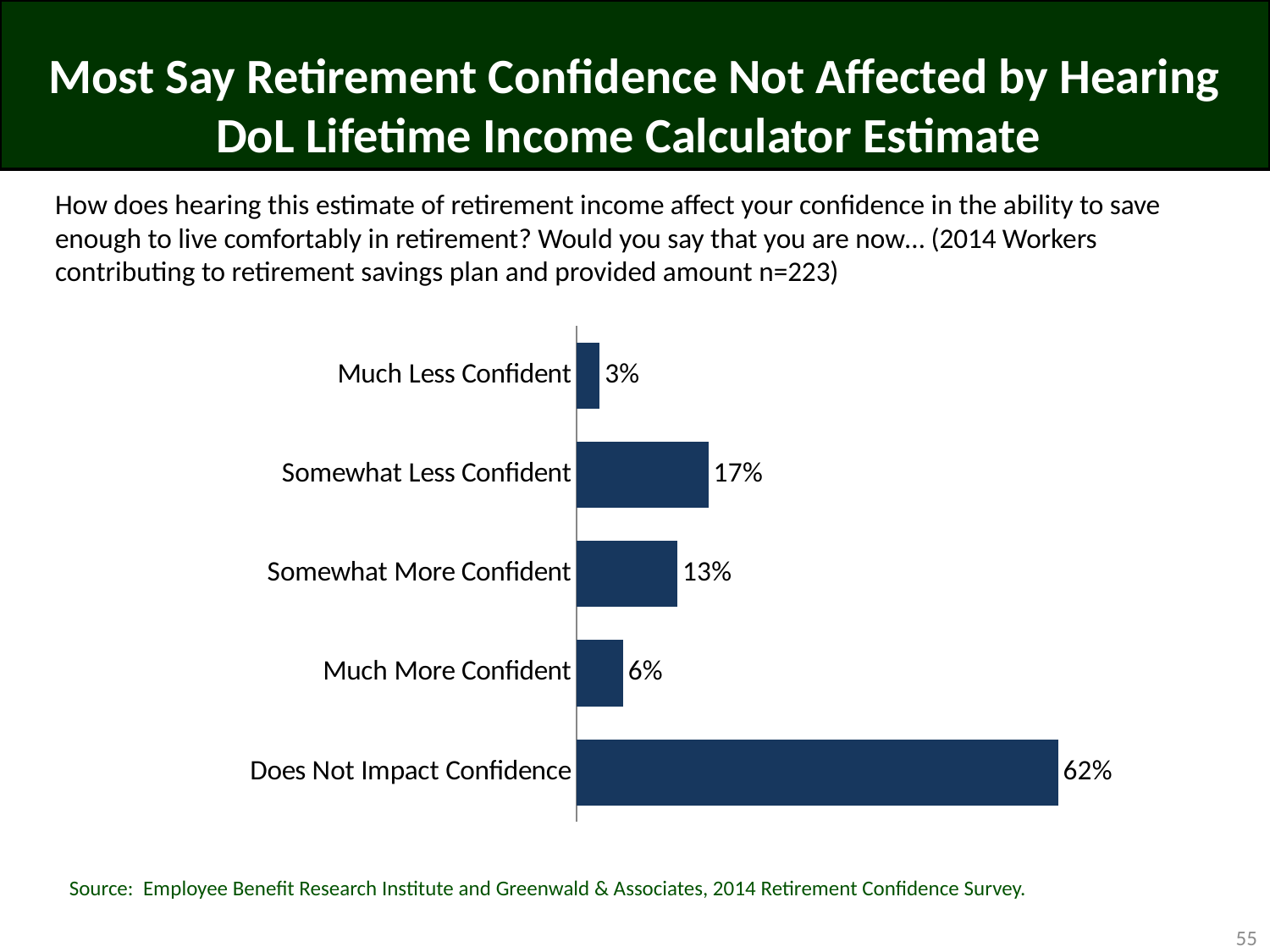
What is the value for Much More Confident? 6% What is the combined value of Somewhat Less Confident and Much Less Confident? 20% What is the sample size (n) stated in the question text above the chart? 223 What is the value for Somewhat Less Confident? 17% Which category has the lowest value? Much Less Confident What is the value for Somewhat More Confident? 13% What percentage of respondents said hearing the estimate does not impact their confidence? 62% What kind of chart is shown on the slide? Bar chart What is the difference between Somewhat Less Confident and Somewhat More Confident? 4% Which category has the highest value? Does Not Impact Confidence How many categories are shown in the chart? 5 Which is larger, Much More Confident or Much Less Confident? Much More Confident